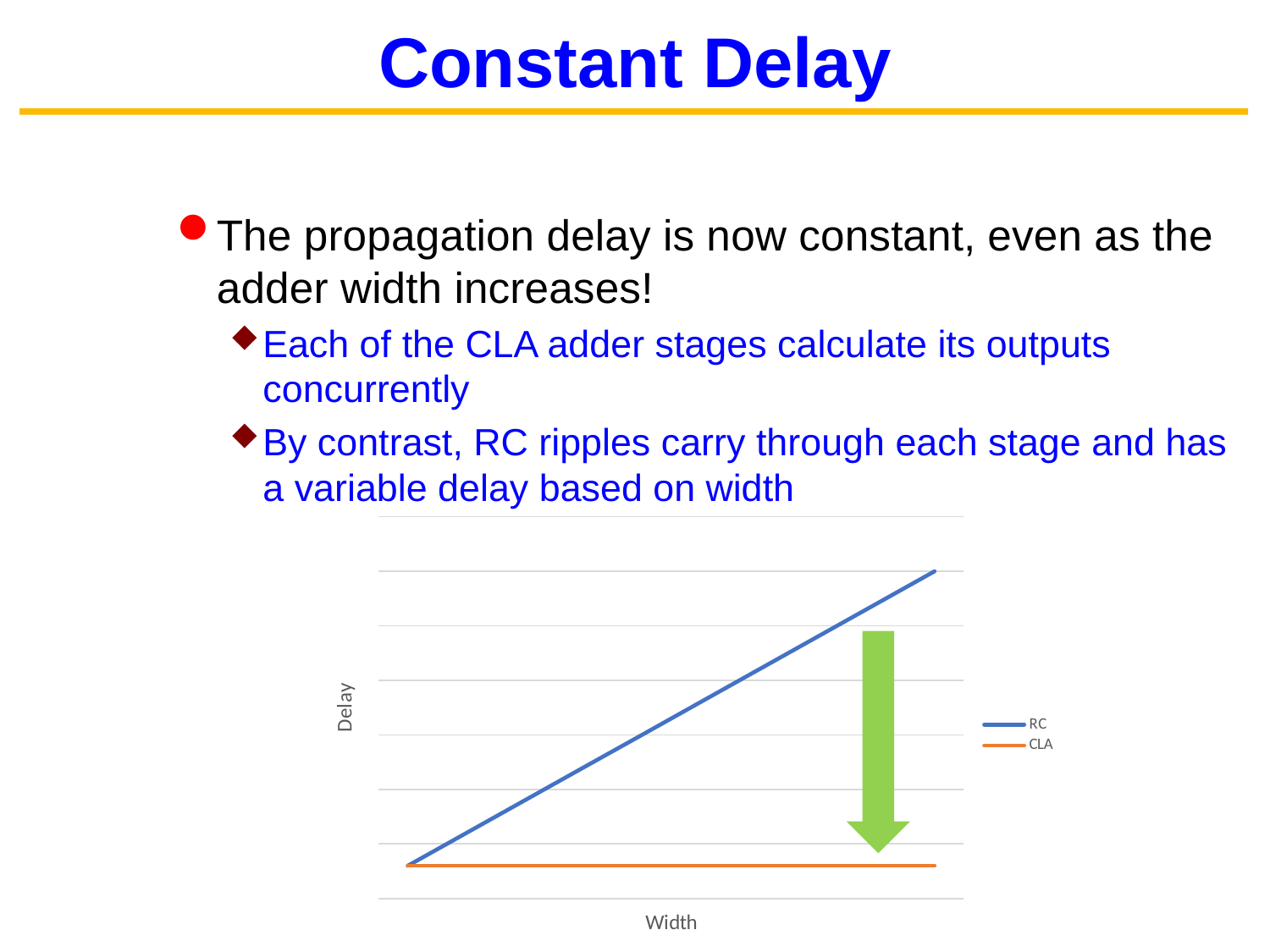
How many series does the chart's legend list? 2 At the right end of the chart, which series shows the larger delay, RC or CLA? RC What kind of chart is shown on the slide? line chart Which series has the higher delay at the largest width shown? RC Does the RC line rise or fall as width increases along the x axis? rises Does the CLA line rise, fall, or stay flat as width increases along the x axis? stays flat What is the label on the chart's vertical axis? Delay Which series has the lower delay at the largest width shown? CLA What is the label on the chart's horizontal axis? Width